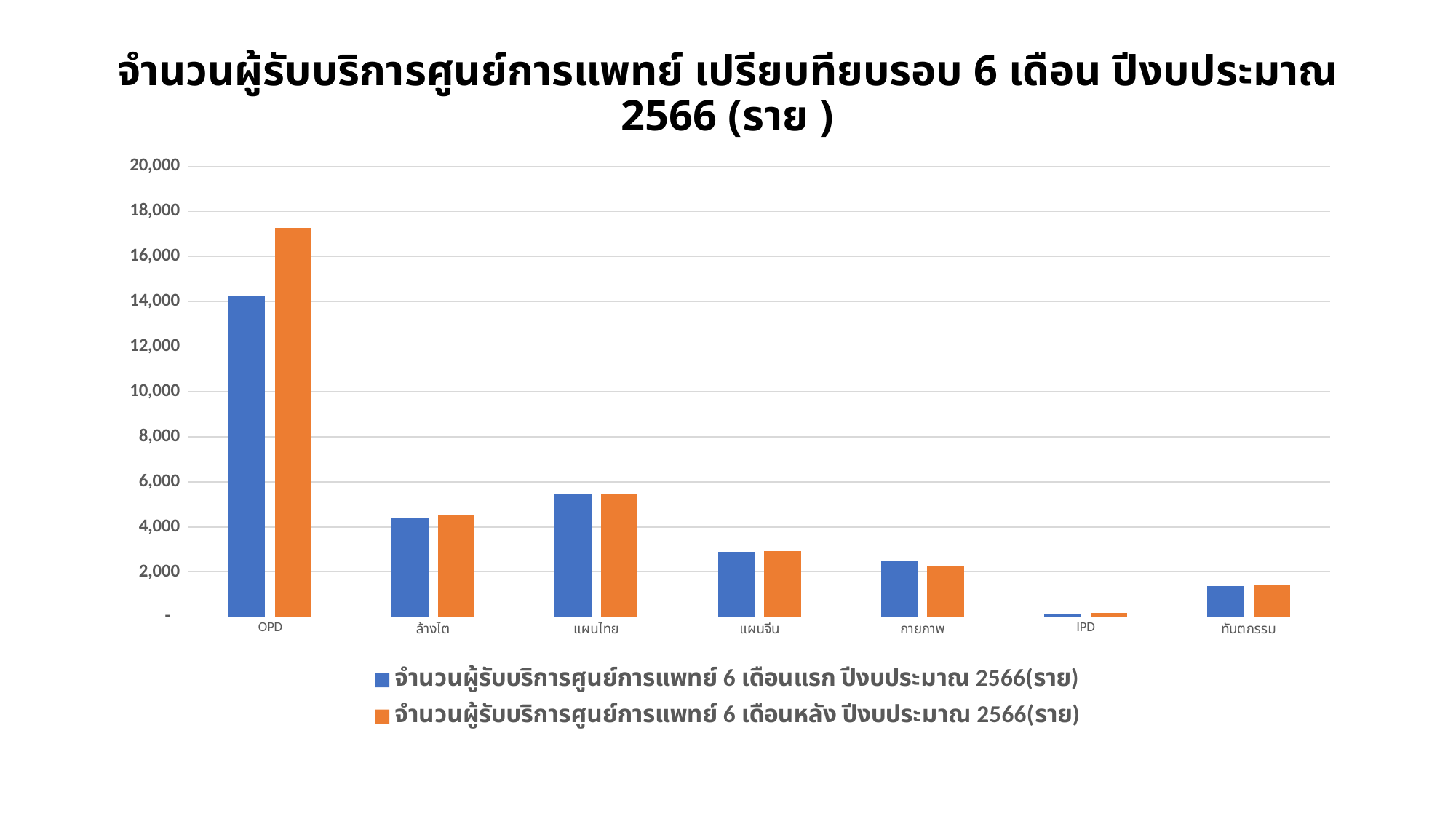
How many categories are shown on the x axis? 7 What kind of chart is shown on the slide? bar chart Which category has the lowest value for the series จำนวนผู้รับบริการศูนย์การแพทย์ 6 เดือนแรก ปีงบประมาณ 2566(ราย)? IPD How many series does the legend list? 2 What colour represents the series จำนวนผู้รับบริการศูนย์การแพทย์ 6 เดือนแรก ปีงบประมาณ 2566(ราย)? blue Is the value for OPD in the 6 เดือนแรก series greater or less than 12,000? greater Is the value for แผนไทย in the 6 เดือนแรก series greater or less than 6,000? less Is the value for ล้างไต in the 6 เดือนหลัง series greater or less than 4,000? greater For กายภาพ, which series has the larger value: 6 เดือนแรก or 6 เดือนหลัง? 6 เดือนแรก For OPD, which series has the larger value: 6 เดือนแรก or 6 เดือนหลัง? 6 เดือนหลัง Which category has the highest value for the series จำนวนผู้รับบริการศูนย์การแพทย์ 6 เดือนหลัง ปีงบประมาณ 2566(ราย)? OPD